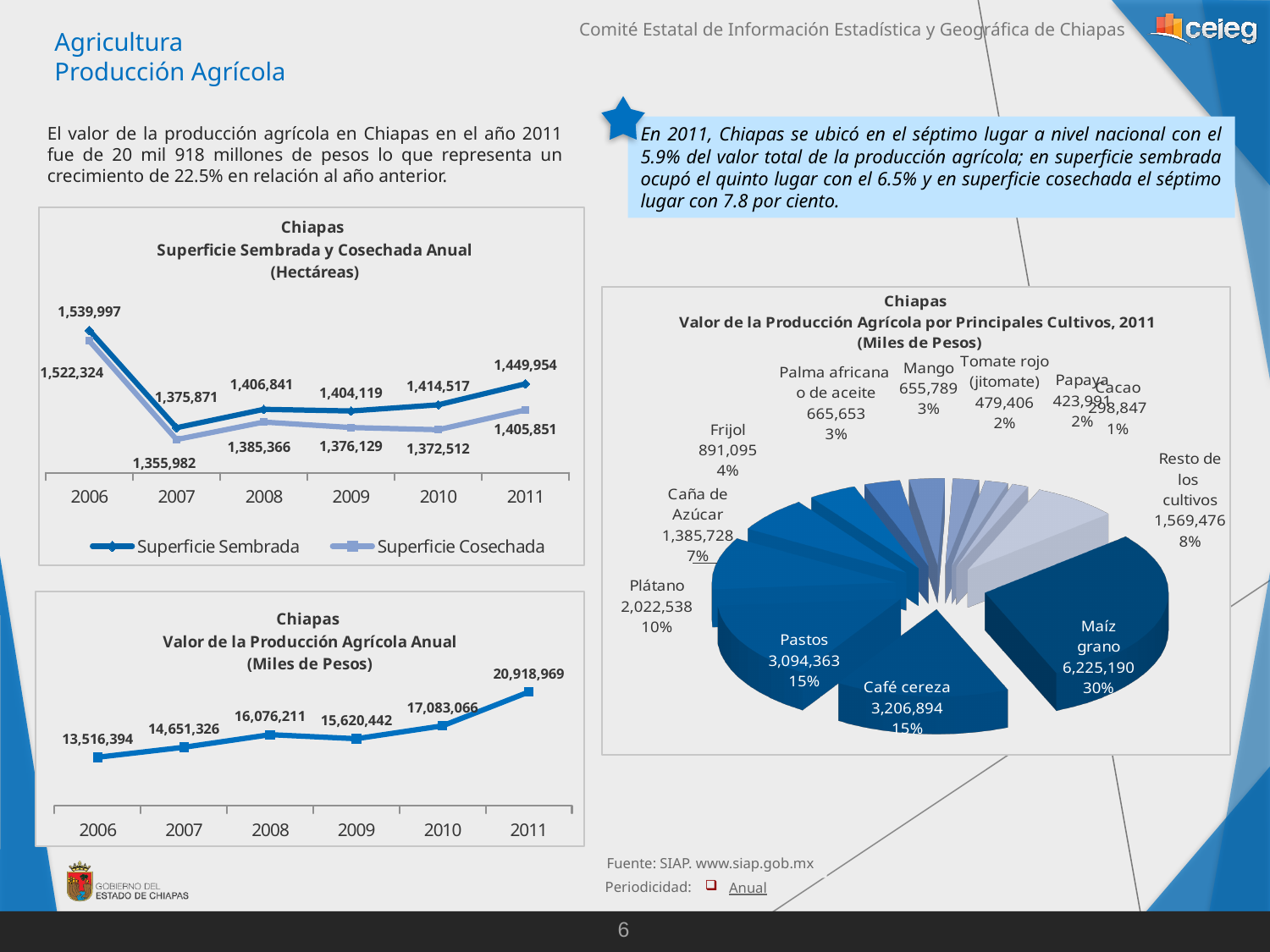
In the pie chart 'Valor de la Producción Agrícola por Principales Cultivos, 2011', what is the value for Plátano? 2,022,538 In the chart 'Superficie Sembrada y Cosechada Anual', what is the Superficie Cosechada value for 2007? 1,355,982 In the chart 'Valor de la Producción Agrícola Anual', what is the value for 2011? 20,918,969 In the pie chart 'Valor de la Producción Agrícola por Principales Cultivos, 2011', what share does Maíz grano have? 30% In the chart 'Valor de la Producción Agrícola Anual', is the value for 2009 larger or smaller than the value for 2008? smaller In the chart 'Superficie Sembrada y Cosechada Anual', which year has the highest Superficie Sembrada value? 2006 How many series does the legend of the chart 'Superficie Sembrada y Cosechada Anual' list? 2 In the pie chart 'Valor de la Producción Agrícola por Principales Cultivos, 2011', which crop has the smallest value? Cacao In the chart 'Valor de la Producción Agrícola Anual', which year has the lowest value? 2006 What type of chart is 'Valor de la Producción Agrícola por Principales Cultivos, 2011'? pie chart In the chart 'Superficie Sembrada y Cosechada Anual', what is the difference between Superficie Sembrada and Superficie Cosechada in 2011? 44,103 In the chart 'Valor de la Producción Agrícola Anual', what is the difference between the 2011 and 2010 values? 3,835,903